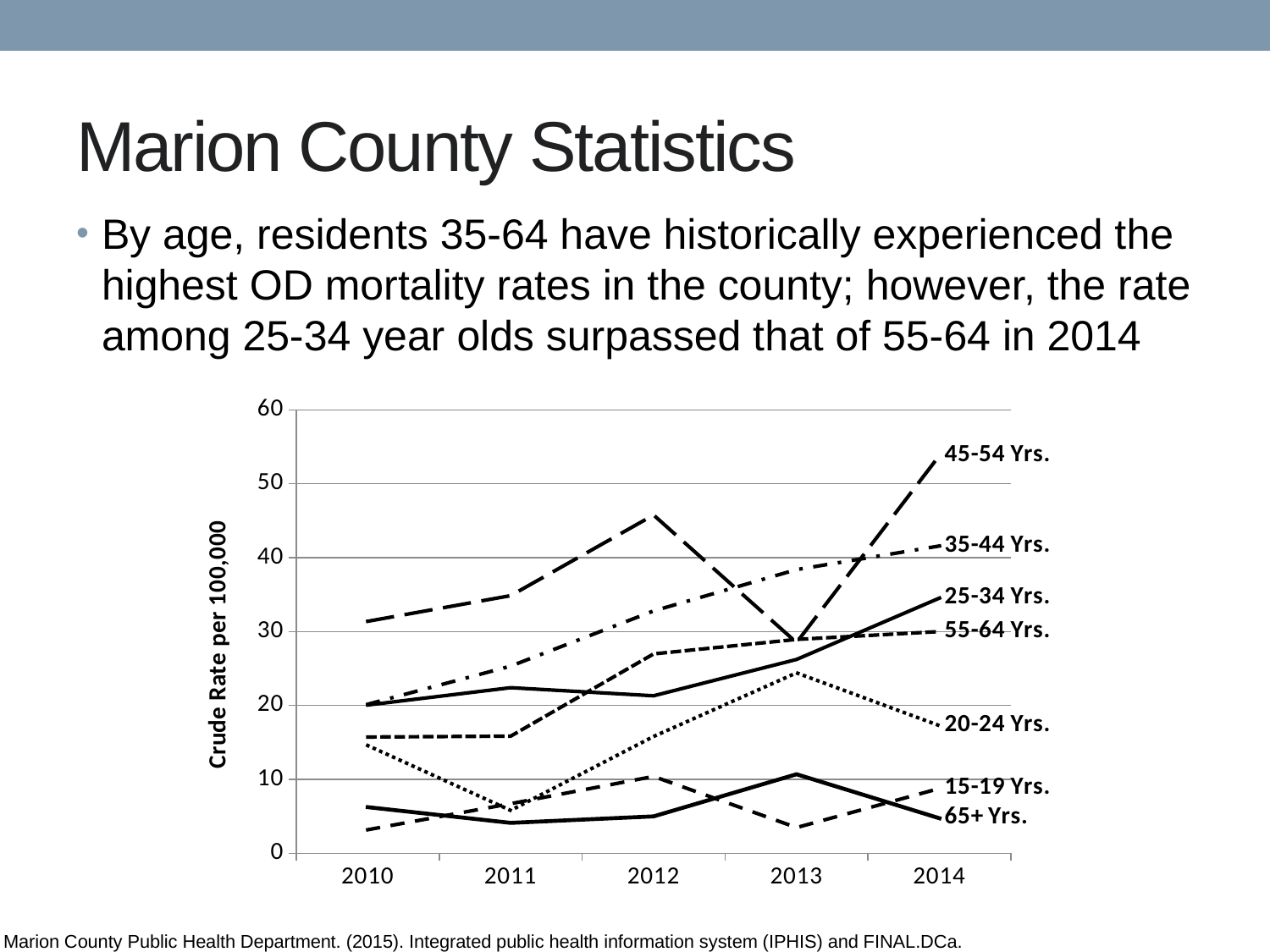
Is the value for 35-44 Yrs. in 2014 greater or less than 40? greater What kind of chart is shown on the slide? line chart Does the rate for 35-44 Yrs. rise or fall from 2010 to 2014? rise Which age group has the highest crude rate in 2012? 45-54 Yrs. Is the value for 45-54 Yrs. in 2014 greater or less than 50? greater What is the title of the vertical axis? Crude Rate per 100,000 Which age group has the highest crude rate in 2014? 45-54 Yrs. How many years are plotted along the x axis? 5 How many age-group series are plotted on the chart? 7 In 2014, which is larger: the rate for 25-34 Yrs. or the rate for 55-64 Yrs.? 25-34 Yrs. Is the value for 15-19 Yrs. in 2010 greater or less than 10? less Which age group has the lowest crude rate in 2014? 65+ Yrs.